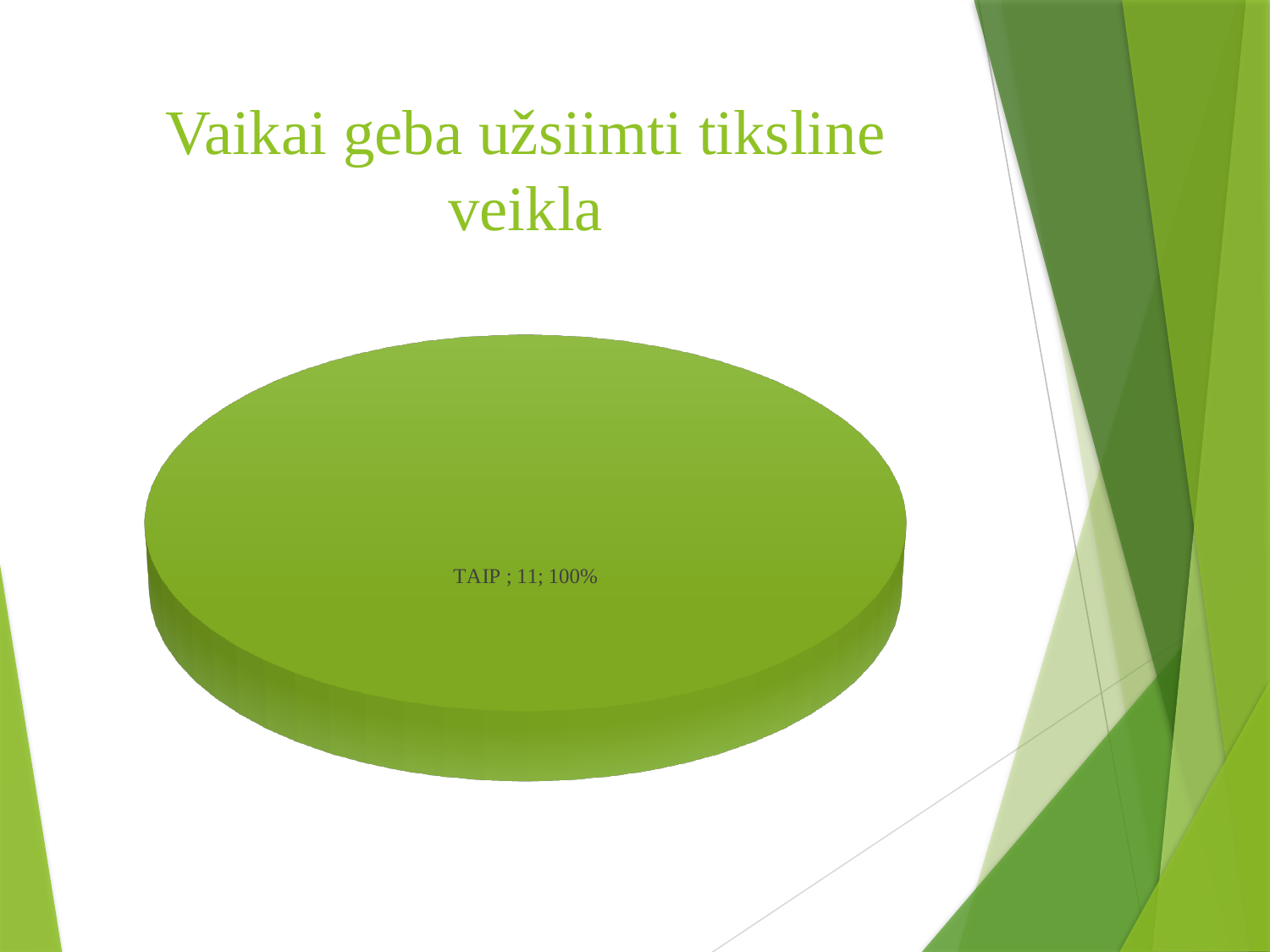
What colour is the TAIP slice in the pie chart? green Which category is the largest in the pie chart? TAIP What is the value for TAIP in the pie chart? 11 How many slices does the pie chart have? 1 What kind of chart is shown on the slide? pie chart What share of the pie does the TAIP slice represent? 100% What is the title of the slide containing the pie chart? Vaikai geba užsiimti tiksline veikla